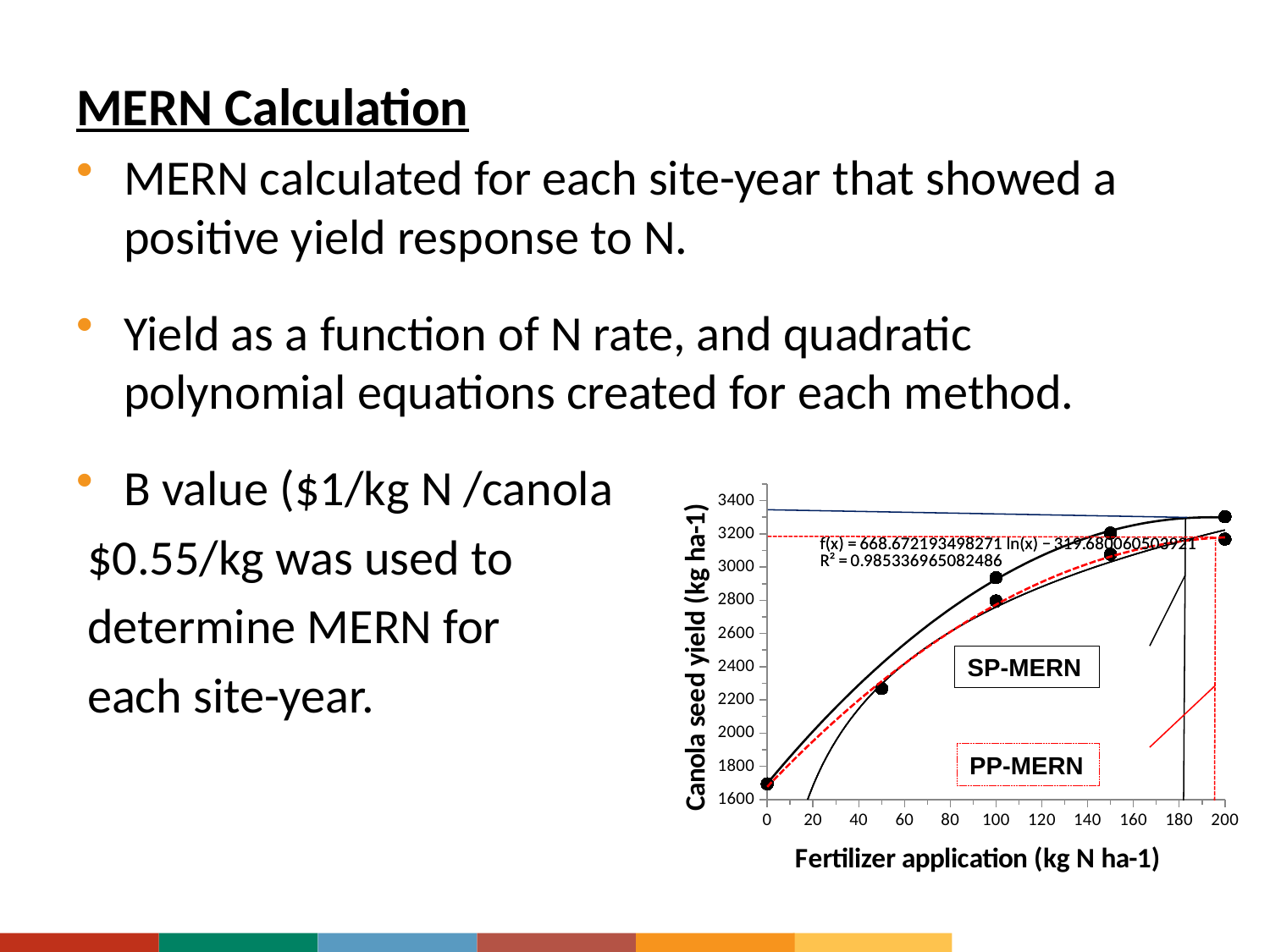
Is the canola seed yield at a fertilizer application of 0 kg N ha-1 greater or less than 1800? less Which fertilizer application rate has the lowest plotted canola seed yield? 0 Do the plotted canola seed yield values rise or fall as fertilizer application increases along the x axis? rise Are the canola seed yield values at a fertilizer application of 100 kg N ha-1 greater or less than 2600? greater Is the canola seed yield at a fertilizer application of 50 kg N ha-1 greater or less than 2000? greater What is the label of the y axis of the chart? Canola seed yield (kg ha-1) Is the plotted yield at 50 kg N ha-1 larger or smaller than the plotted yield at 100 kg N ha-1? smaller What kind of chart is shown on the slide? scatter chart What is the label of the x axis of the chart? Fertilizer application (kg N ha-1)